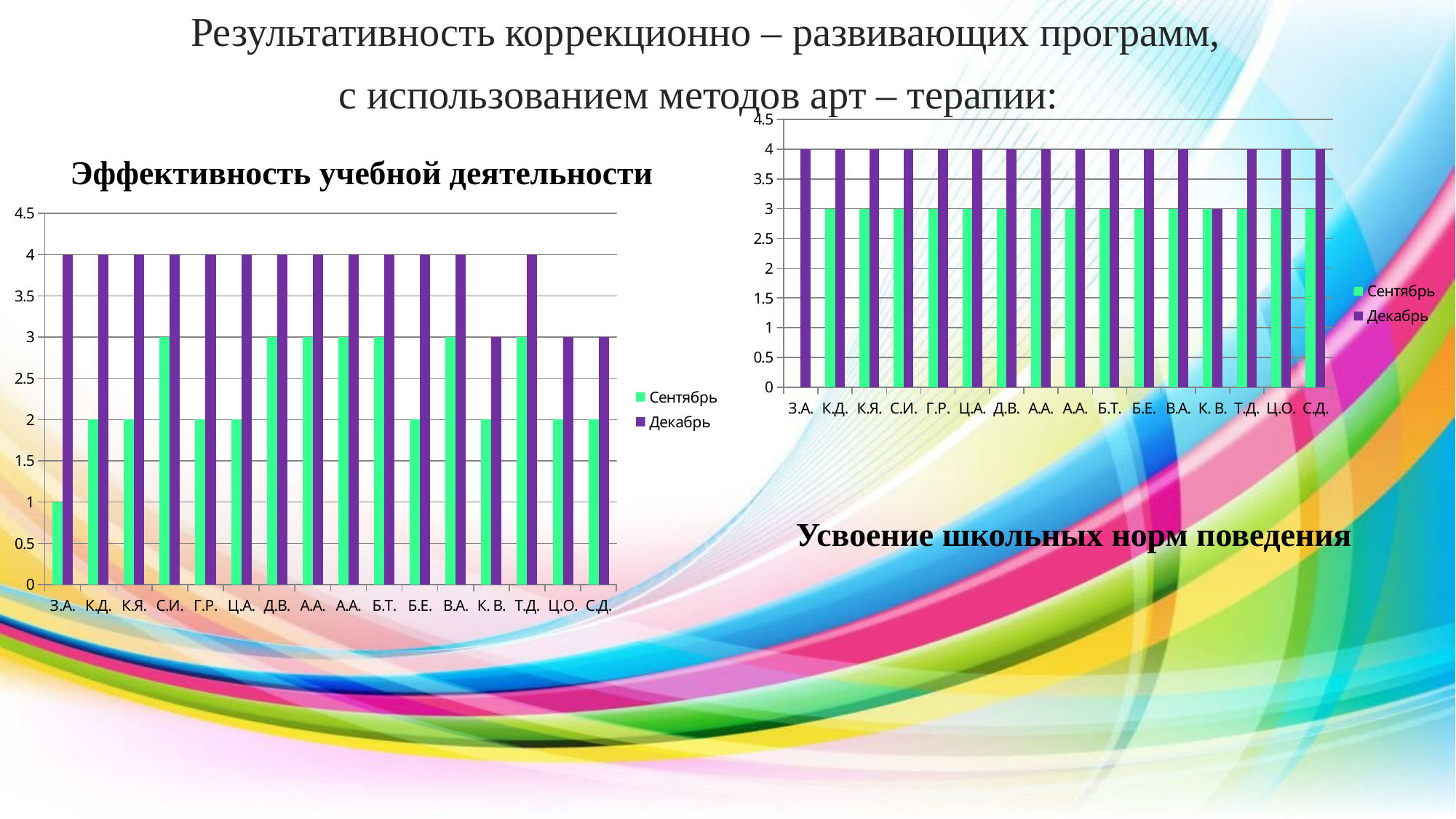
On the chart titled "Усвоение школьных норм поведения", what is the Сентябрь value for К.Д.? 3 On the chart titled "Эффективность учебной деятельности", which category has the lowest Сентябрь value? З.А. On the chart titled "Эффективность учебной деятельности", which colour represents the Декабрь series? Purple On the chart titled "Эффективность учебной деятельности", what is the Сентябрь value for З.А.? 1 On the chart titled "Эффективность учебной деятельности", what is the Декабрь value for К.В.? 3 On the chart titled "Эффективность учебной деятельности", how many series does the legend list? 2 On the chart titled "Усвоение школьных норм поведения", what is the Декабрь value for К.В.? 3 What kind of chart is the chart titled "Усвоение школьных норм поведения"? Bar chart On the chart titled "Усвоение школьных норм поведения", what is the difference between the Декабрь and Сентябрь values for С.Д.? 1 On the chart titled "Эффективность учебной деятельности", what is the difference between the Декабрь and Сентябрь values for З.А.? 3 On the chart titled "Усвоение школьных норм поведения", which is larger for Т.Д., the Сентябрь value or the Декабрь value? Декабрь On the chart titled "Эффективность учебной деятельности", how many categories are shown on the x axis? 16